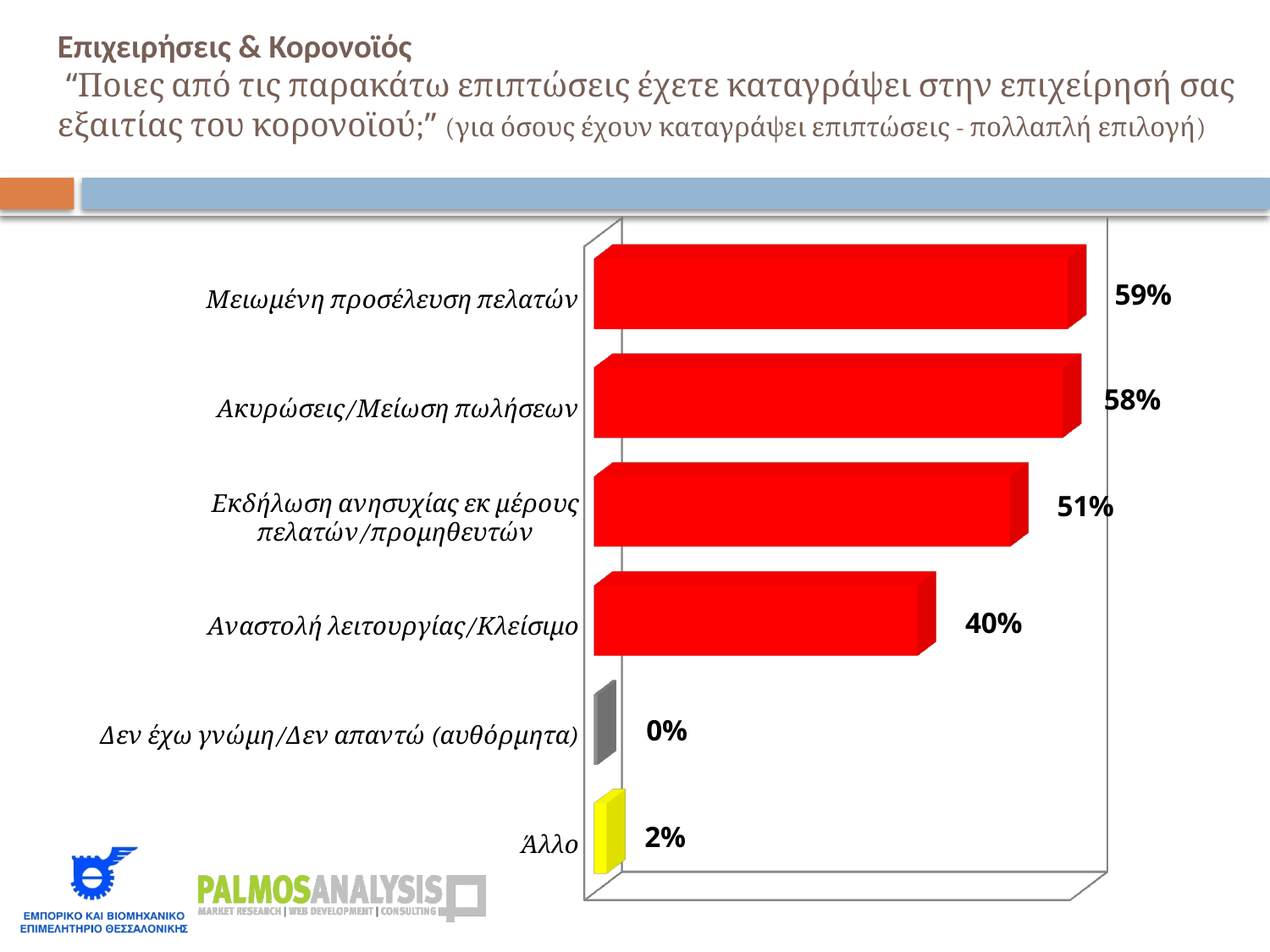
What colour is the bar for Άλλο? Yellow What kind of chart is shown on the slide? Bar chart What is the value for Ακυρώσεις/Μείωση πωλήσεων? 58% Which category has the highest value? Μειωμένη προσέλευση πελατών What is the difference between the values for Μειωμένη προσέλευση πελατών and Αναστολή λειτουργίας/Κλείσιμο? 19% What is the value for Άλλο? 2% What is the value for Αναστολή λειτουργίας/Κλείσιμο? 40% How many categories are shown in the chart? 6 Which is larger: the value for Εκδήλωση ανησυχίας εκ μέρους πελατών/προμηθευτών or the value for Αναστολή λειτουργίας/Κλείσιμο? Εκδήλωση ανησυχίας εκ μέρους πελατών/προμηθευτών What is the value for Εκδήλωση ανησυχίας εκ μέρους πελατών/προμηθευτών? 51% What is the value for Μειωμένη προσέλευση πελατών? 59% Which category has the lowest value? Δεν έχω γνώμη/Δεν απαντώ (αυθόρμητα)